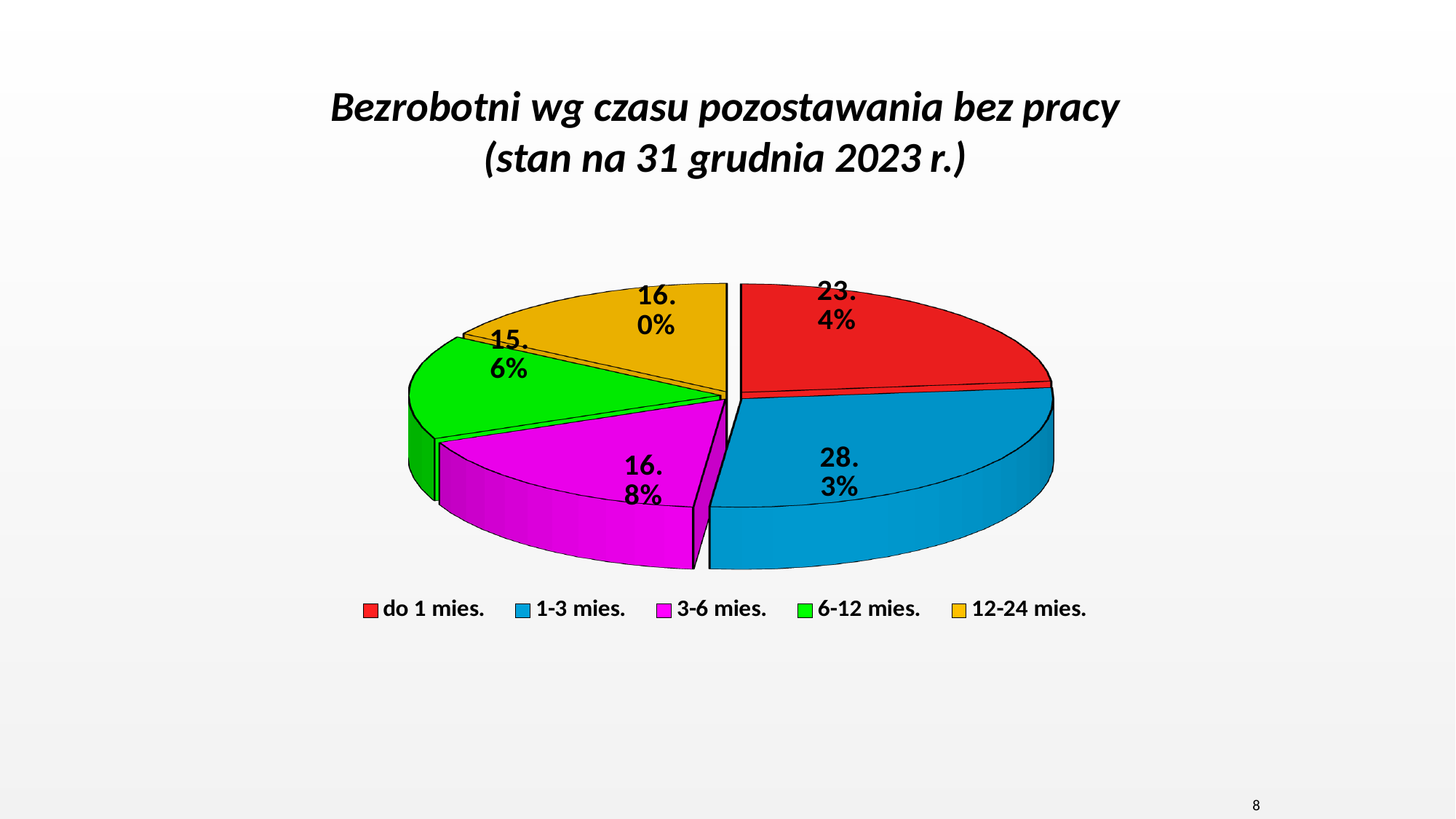
Which category has the smallest share of the pie? 6-12 mies. What share of the pie does the '12-24 mies.' slice represent? 16.0% What share of the pie does the '6-12 mies.' slice represent? 15.6% How many slices does the pie chart have? 5 What colour is the '12-24 mies.' slice? Orange What kind of chart is shown on the slide? Pie chart What share of the pie does the '1-3 mies.' slice represent? 28.3% What share of the pie does the 'do 1 mies.' slice represent? 23.4% Which category has the largest share of the pie? 1-3 mies. What share of the pie does the '3-6 mies.' slice represent? 16.8% What is the difference in percentage points between the '1-3 mies.' and 'do 1 mies.' slices? 4.9 Which slice is larger: '1-3 mies.' or 'do 1 mies.'? 1-3 mies.